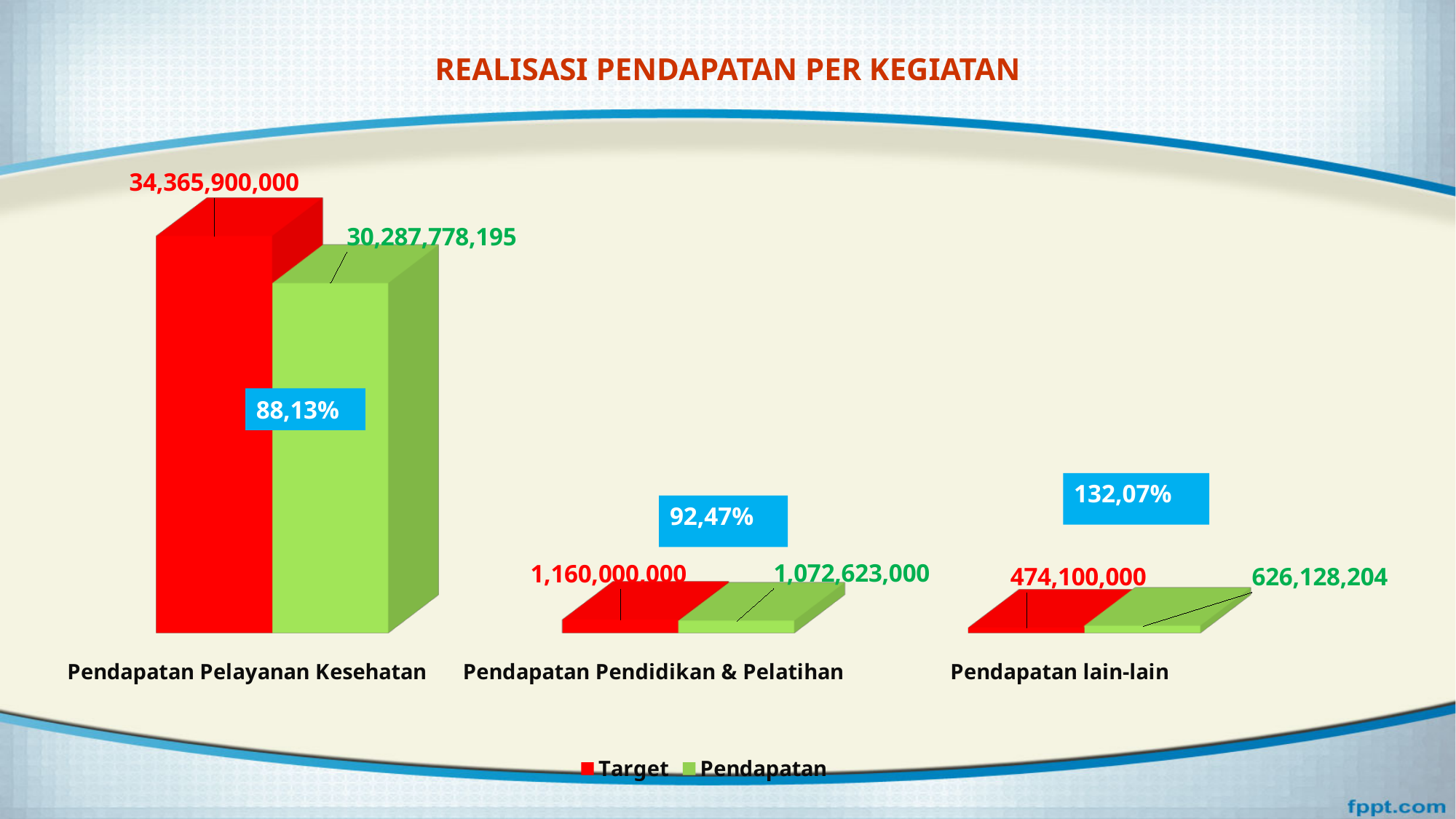
Which category has the lowest Pendapatan value? Pendapatan lain-lain What type of chart is shown on the slide? Bar chart What is the Pendapatan value for Pendapatan lain-lain? 626,128,204 What is the Target value for Pendapatan Pendidikan & Pelatihan? 1,160,000,000 What is the Pendapatan value for Pendapatan Pelayanan Kesehatan? 30,287,778,195 How many series does the legend list? 2 For Pendapatan lain-lain, which is larger: Target or Pendapatan? Pendapatan What percentage is shown in the box above the Pendapatan lain-lain bars? 132,07% How many categories are shown on the x axis? 3 Which category has the highest Target value? Pendapatan Pelayanan Kesehatan What is the difference between Target and Pendapatan for Pendapatan Pendidikan & Pelatihan? 87,377,000 What is the Target value for Pendapatan Pelayanan Kesehatan? 34,365,900,000